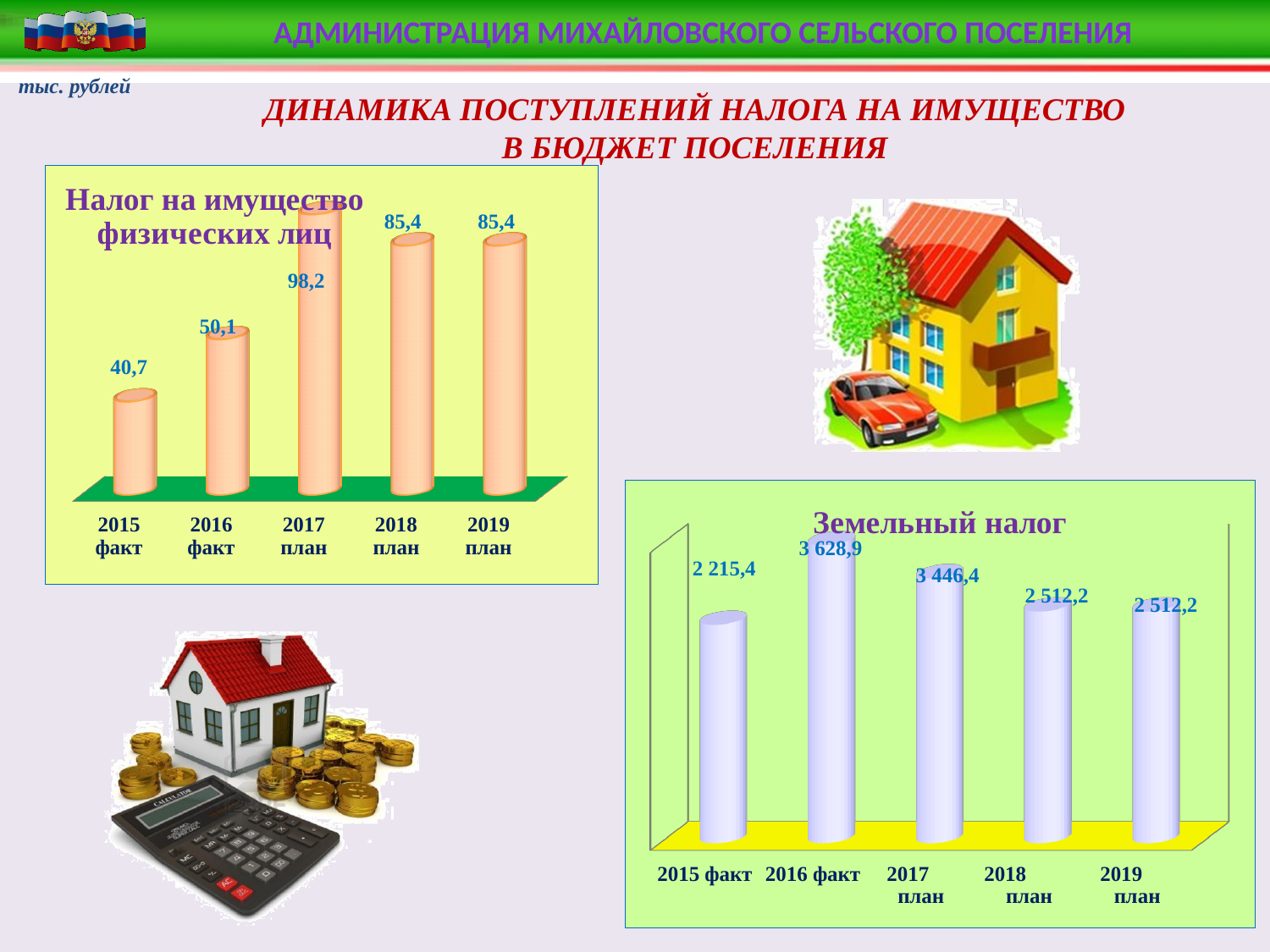
On the chart titled "Земельный налог", which category has the highest value? 2016 факт On the chart titled "Налог на имущество физических лиц", how many categories are shown? 5 On the chart titled "Налог на имущество физических лиц", what is the value for 2015 факт? 40,7 On the chart titled "Налог на имущество физических лиц", which category has the lowest value? 2015 факт On the chart titled "Налог на имущество физических лиц", what is the value for 2017 план? 98,2 On the chart titled "Земельный налог", what is the value for 2018 план? 2 512,2 On the chart titled "Налог на имущество физических лиц", which category has the highest value? 2017 план On the chart titled "Земельный налог", which category has the lowest value? 2015 факт On the chart titled "Налог на имущество физических лиц", what is the difference between the values for 2016 факт and 2015 факт? 9,4 What kind of chart is the chart titled "Земельный налог"? Bar chart On the chart titled "Земельный налог", which is larger: the value for 2017 план or the value for 2019 план? 2017 план On the chart titled "Земельный налог", what is the value for 2016 факт? 3 628,9